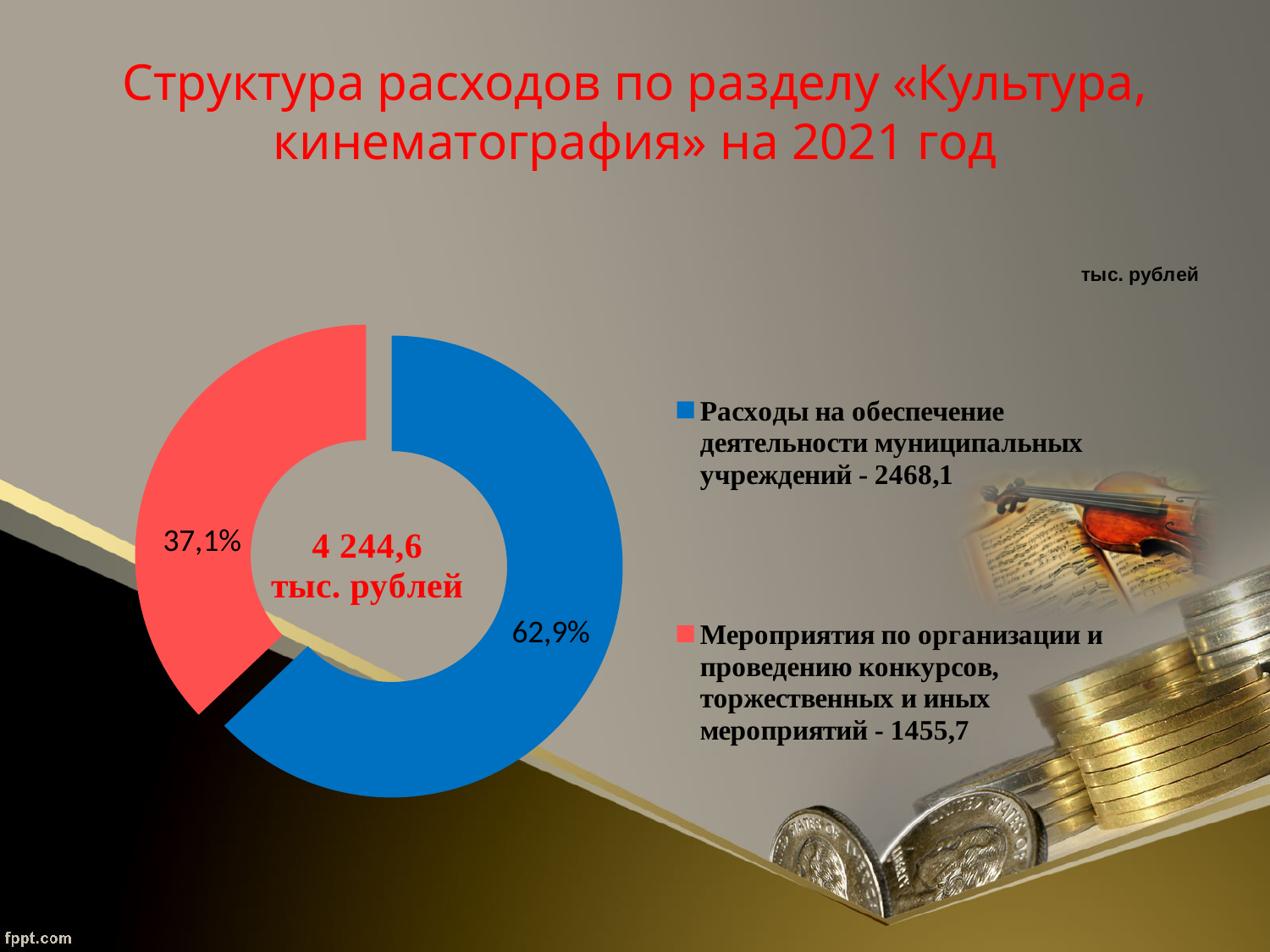
What is the total amount shown in the centre of the chart? 4 244,6 тыс. рублей Which is larger: the share for «Расходы на обеспечение деятельности муниципальных учреждений» or the share for «Мероприятия по организации и проведению конкурсов, торжественных и иных мероприятий»? Расходы на обеспечение деятельности муниципальных учреждений What is the value (тыс. рублей) for «Мероприятия по организации и проведению конкурсов, торжественных и иных мероприятий»? 1455,7 What share of the chart does the slice «Расходы на обеспечение деятельности муниципальных учреждений» take? 62,9% What is the difference in тыс. рублей between «Расходы на обеспечение деятельности муниципальных учреждений» and «Мероприятия по организации и проведению конкурсов, торжественных и иных мероприятий»? 1012,4 What kind of chart is shown on the slide? doughnut (pie) chart Which category has the smallest share of the chart? Мероприятия по организации и проведению конкурсов, торжественных и иных мероприятий What share of the chart does the slice «Мероприятия по организации и проведению конкурсов, торжественных и иных мероприятий» take? 37,1% How many slices does the chart have? 2 What is the value (тыс. рублей) for «Расходы на обеспечение деятельности муниципальных учреждений»? 2468,1 Which category has the largest share of the chart? Расходы на обеспечение деятельности муниципальных учреждений What colour is the slice for «Мероприятия по организации и проведению конкурсов, торжественных и иных мероприятий»? red